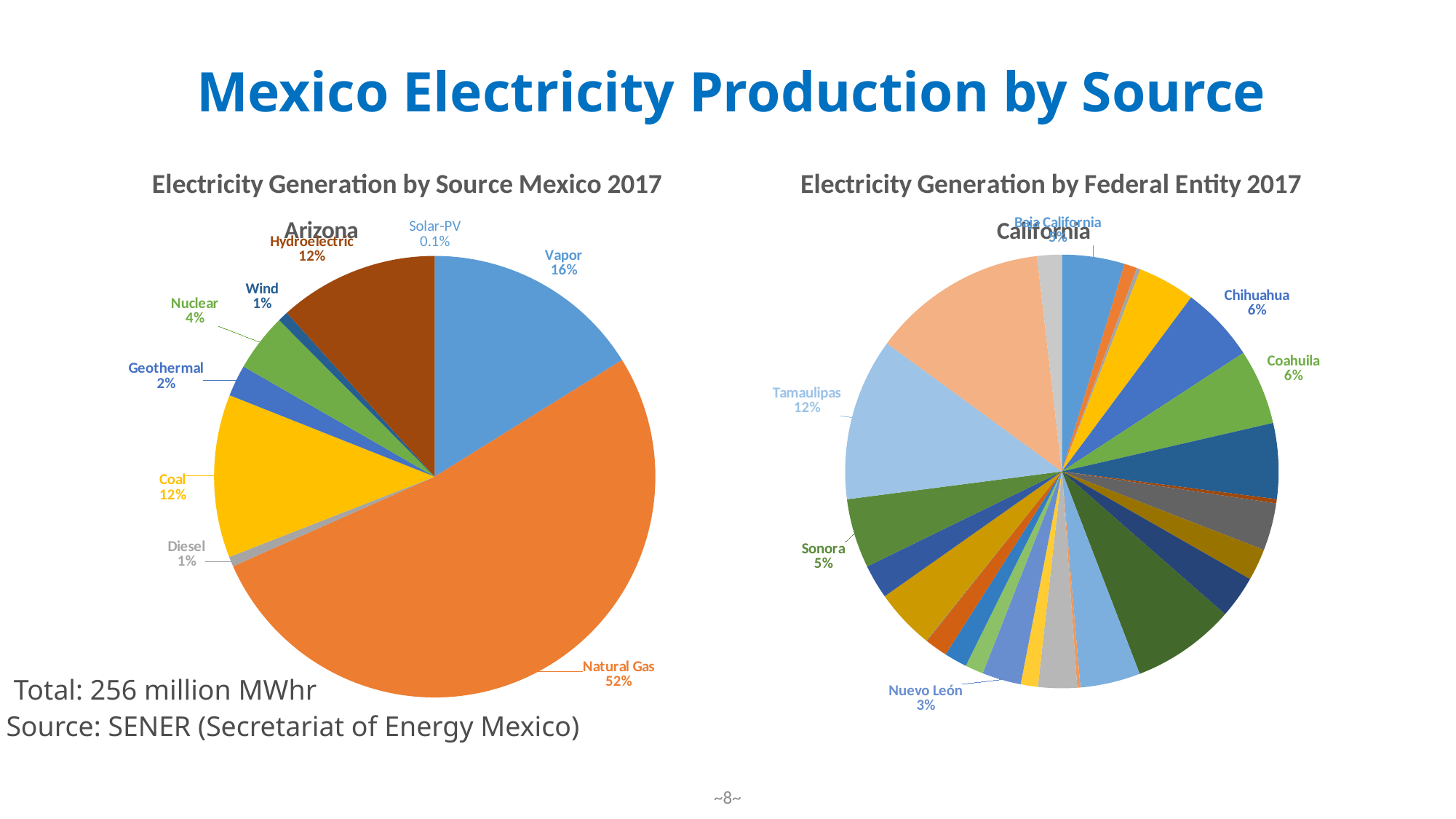
In the 'Electricity Generation by Federal Entity 2017' chart, what is the value for Chihuahua? 6% In the 'Electricity Generation by Source Mexico 2017' chart, what share does Natural Gas have? 52% In the 'Electricity Generation by Source Mexico 2017' chart, which is larger, Nuclear or Geothermal? Nuclear In the 'Electricity Generation by Source Mexico 2017' chart, what is the value for Vapor? 16% In the 'Electricity Generation by Source Mexico 2017' chart, which source has the largest share? Natural Gas In the 'Electricity Generation by Federal Entity 2017' chart, which is larger, Sonora or Nuevo León? Sonora In the 'Electricity Generation by Federal Entity 2017' chart, what is the value for Tamaulipas? 12% In the 'Electricity Generation by Source Mexico 2017' chart, what is the difference between the Vapor share and the Coal share? 4 percentage points How many sources are shown in the 'Electricity Generation by Source Mexico 2017' pie chart? 9 What kind of chart is the 'Electricity Generation by Source Mexico 2017' chart? Pie chart In the 'Electricity Generation by Federal Entity 2017' chart, what is the difference between the Tamaulipas share and the Sonora share? 7 percentage points In the 'Electricity Generation by Source Mexico 2017' chart, which source has the smallest share? Solar-PV